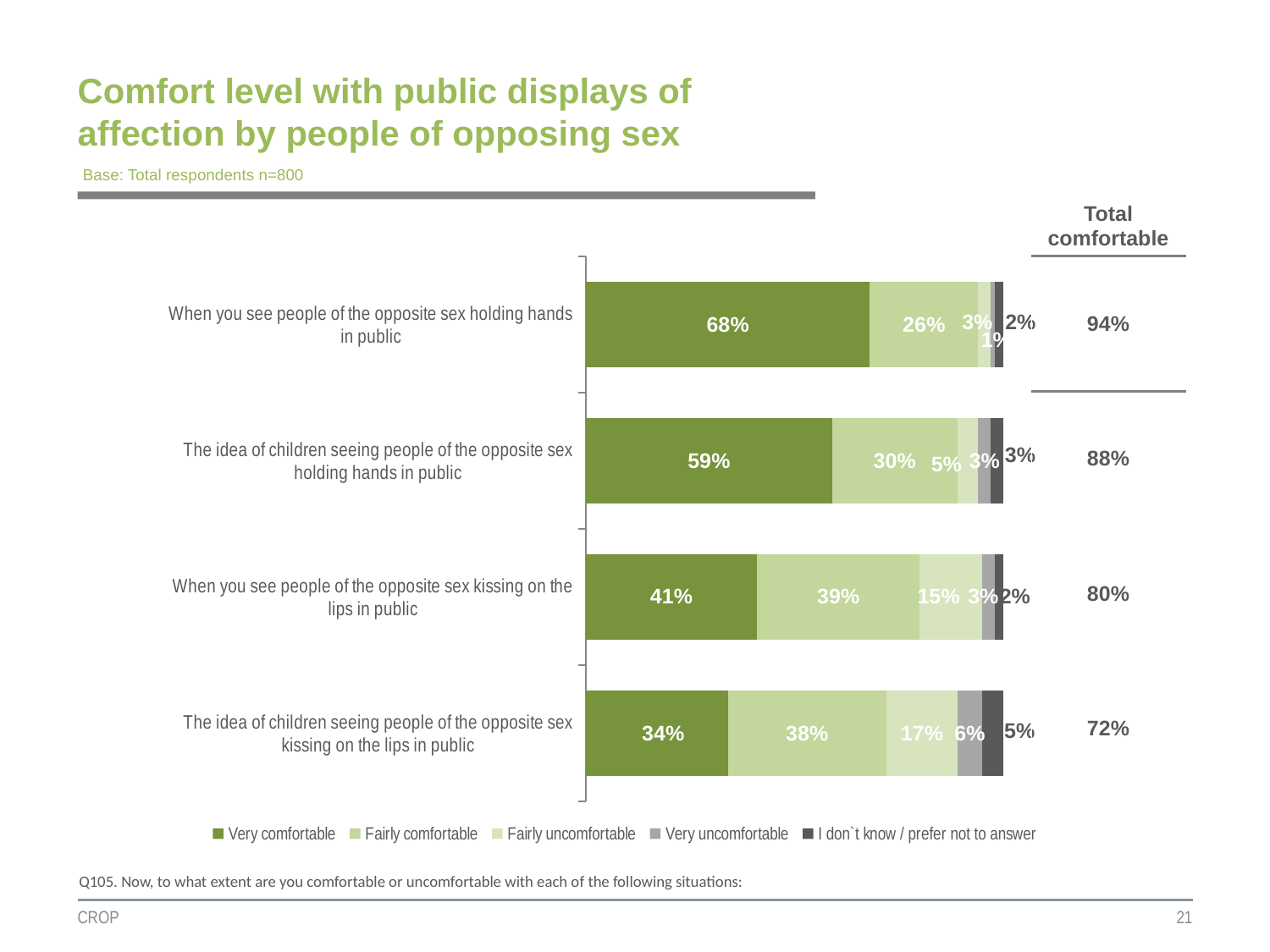
How many situations (categories) are plotted in the chart? 4 Which situation has the highest 'Very comfortable' percentage? When you see people of the opposite sex holding hands in public What kind of chart is shown on the slide? Stacked bar chart Which is larger: the 'Very uncomfortable' value for children seeing people of the opposite sex kissing on the lips in public, or for children seeing people of the opposite sex holding hands in public? Children seeing people of the opposite sex kissing on the lips in public (6%) What is the title of the chart on the slide? Comfort level with public displays of affection by people of opposing sex What percentage of respondents are very comfortable when they see people of the opposite sex holding hands in public? 68% What is the difference between the 'Very comfortable' values for people of the opposite sex holding hands in public and kissing on the lips in public? 27 percentage points What is the 'Fairly uncomfortable' value for when you see people of the opposite sex kissing on the lips in public? 15% What is the total comfortable figure for the idea of children seeing people of the opposite sex holding hands in public? 88% How many series does the legend list? 5 What is the 'Fairly comfortable' value for the idea of children seeing people of the opposite sex kissing on the lips in public? 38% Which situation has the lowest total comfortable figure? The idea of children seeing people of the opposite sex kissing on the lips in public